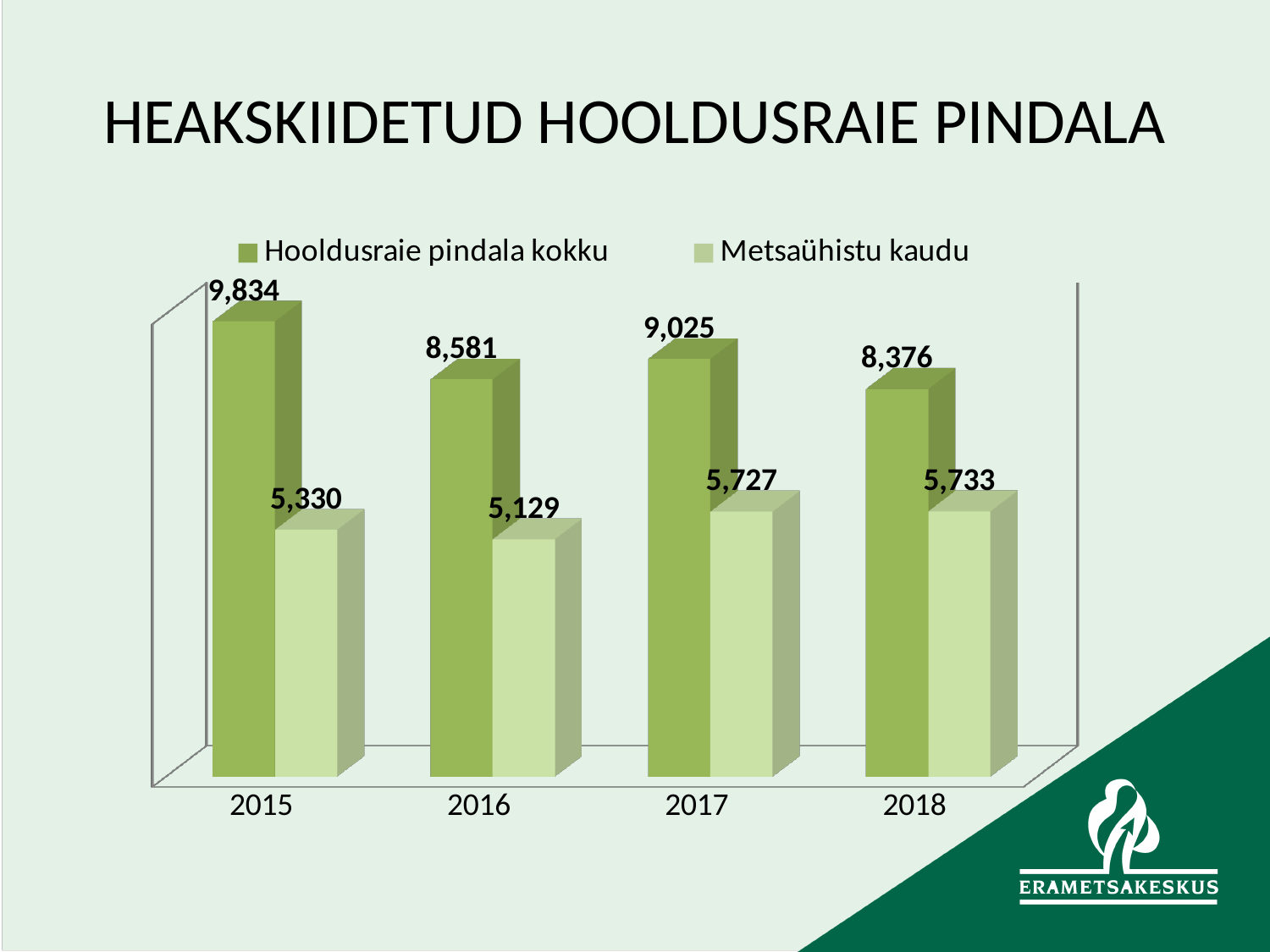
What is the title of the slide? HEAKSKIIDETUD HOOLDUSRAIE PINDALA What is the value of Metsaühistu kaudu for 2016? 5,129 What kind of chart is shown on the slide? Bar chart What is the value of Hooldusraie pindala kokku for 2015? 9,834 How many years are shown on the x axis? 4 What is the value of Hooldusraie pindala kokku for 2018? 8,376 How many series does the legend list? 2 Which year has the lowest value for Metsaühistu kaudu? 2016 Which year has the highest value for Hooldusraie pindala kokku? 2015 Which is larger: Hooldusraie pindala kokku in 2016 or in 2018? 2016 What is the difference between Hooldusraie pindala kokku and Metsaühistu kaudu in 2017? 3,298 What is the value of Metsaühistu kaudu for 2017? 5,727